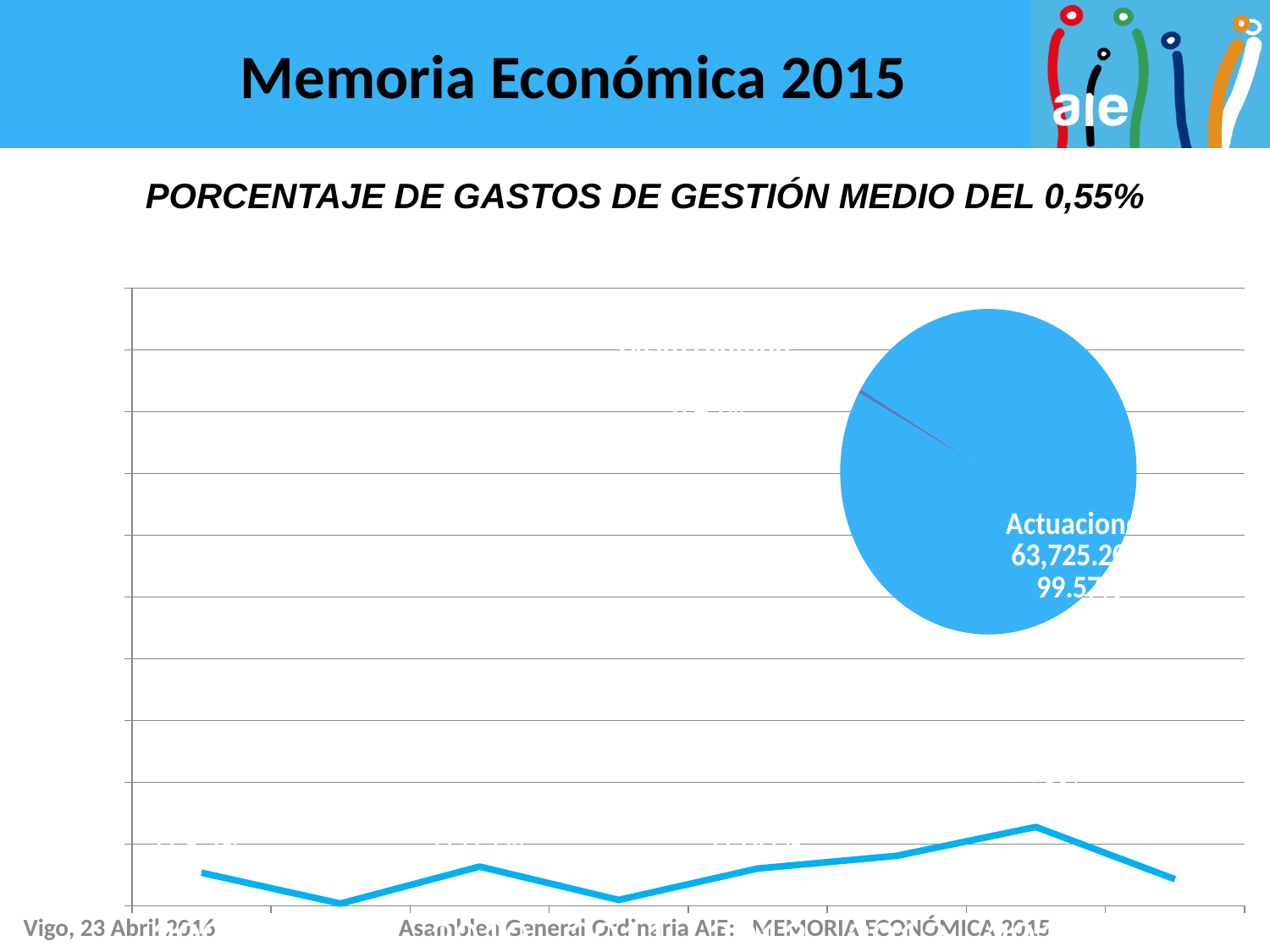
What kind of chart is the large chart spanning the slide with the blue line near the bottom? line chart What is the subtitle printed above the charts on the slide? PORCENTAJE DE GASTOS DE GESTIÓN MEDIO DEL 0,55% In the line chart, is the second point from the left higher or lower than the first point? lower What kind of chart is the chart in the upper right of the slide? pie chart In the line chart, is the seventh point from the left higher or lower than the last point? higher In the line chart, does the line rise or fall between the seventh and eighth points? fall In the line chart, does the line rise or fall between the fifth and seventh points from the left? rise In the pie chart, what colour is the slice that takes up almost the whole pie? blue In the line chart, which point is the highest: the seventh from the left or the fourth from the left? the seventh from the left How many data points does the blue line in the line chart plot? 8